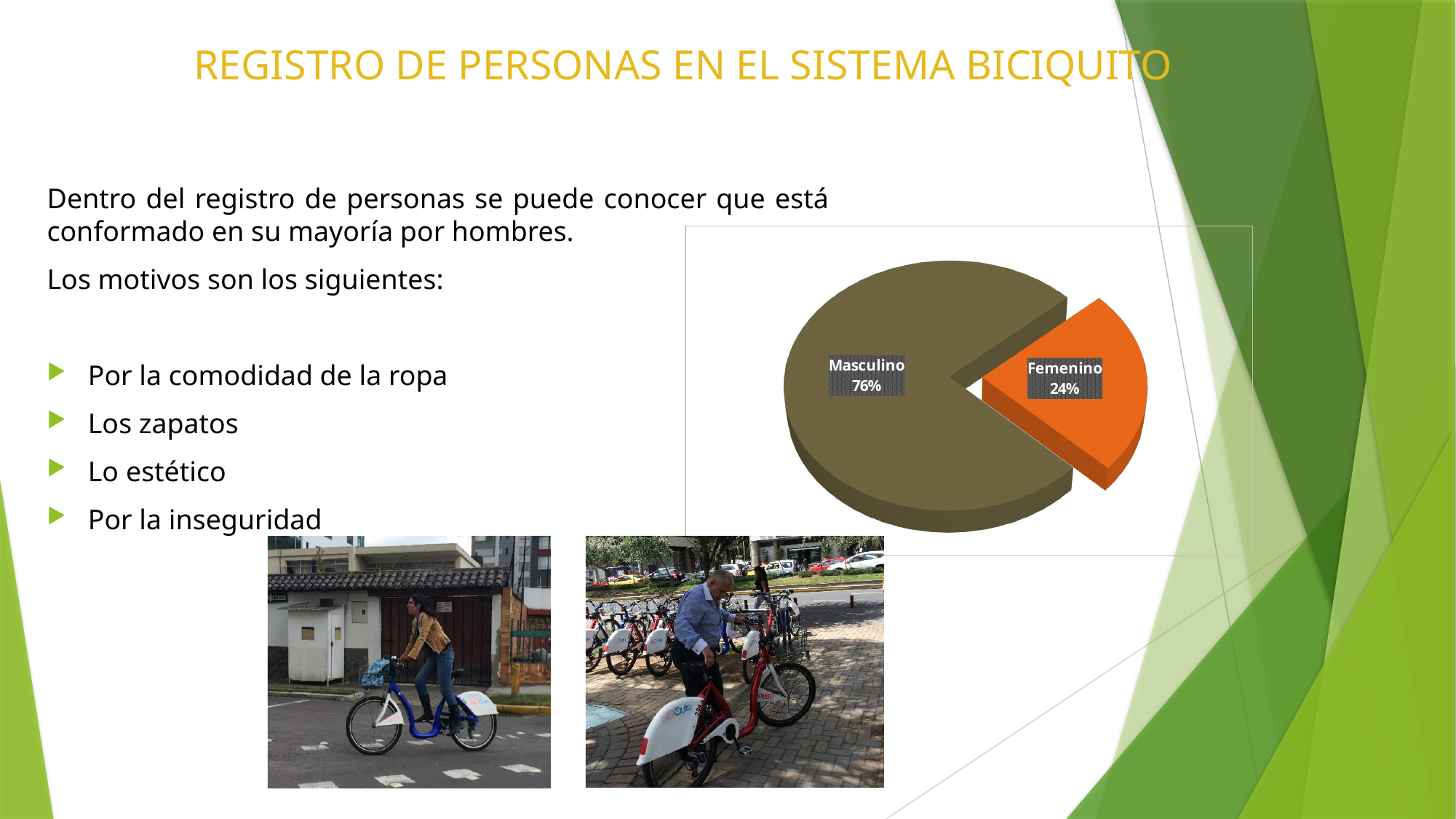
Which slice of the pie chart is the largest? Masculino Which slice of the pie chart is the smallest? Femenino What percentage of the pie chart is Masculino? 76% How many slices does the pie chart have? 2 Which slice of the pie chart is pulled out (exploded) from the rest? Femenino What kind of chart is shown on the slide? Pie chart What colour is the Femenino slice in the pie chart? Orange What is the difference in percentage points between the Masculino and Femenino slices? 52 Which is larger in the pie chart, Masculino or Femenino? Masculino What percentage of the pie chart is Femenino? 24%